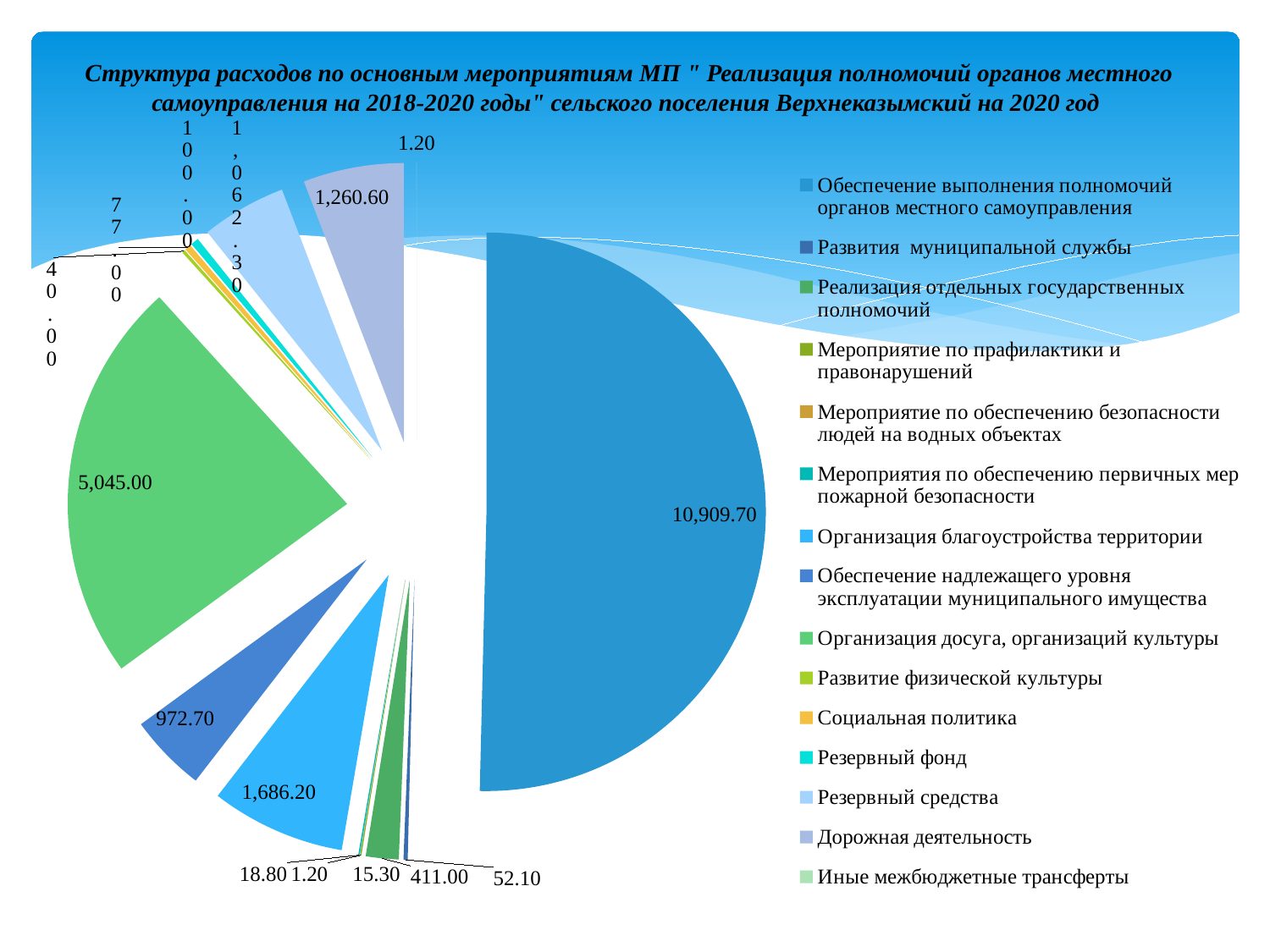
What is the difference between the slices labelled 1,686.20 and 972.70? 713.50 Which category has the largest slice in the pie chart? Обеспечение выполнения полномочий органов местного самоуправления What is the value of the largest slice in the pie chart? 10,909.70 What kind of chart is shown on the slide? pie chart What is the difference between the two largest slices, 10,909.70 and 5,045.00? 5,864.70 What is the value of the slice for Организация досуга, организаций культуры? 5,045.00 What is the smallest value printed as a data label on the pie chart? 1.20 Which is larger, the slice labelled 1,686.20 or the slice labelled 972.70? 1,686.20 Which is larger, the slice labelled 1,260.60 or the slice labelled 1,062.30? 1,260.60 For which year does the chart title say the expenditure structure is shown? 2020 What is the value of the slice for Дорожная деятельность? 1,260.60 How many entries does the legend of the pie chart list? 15